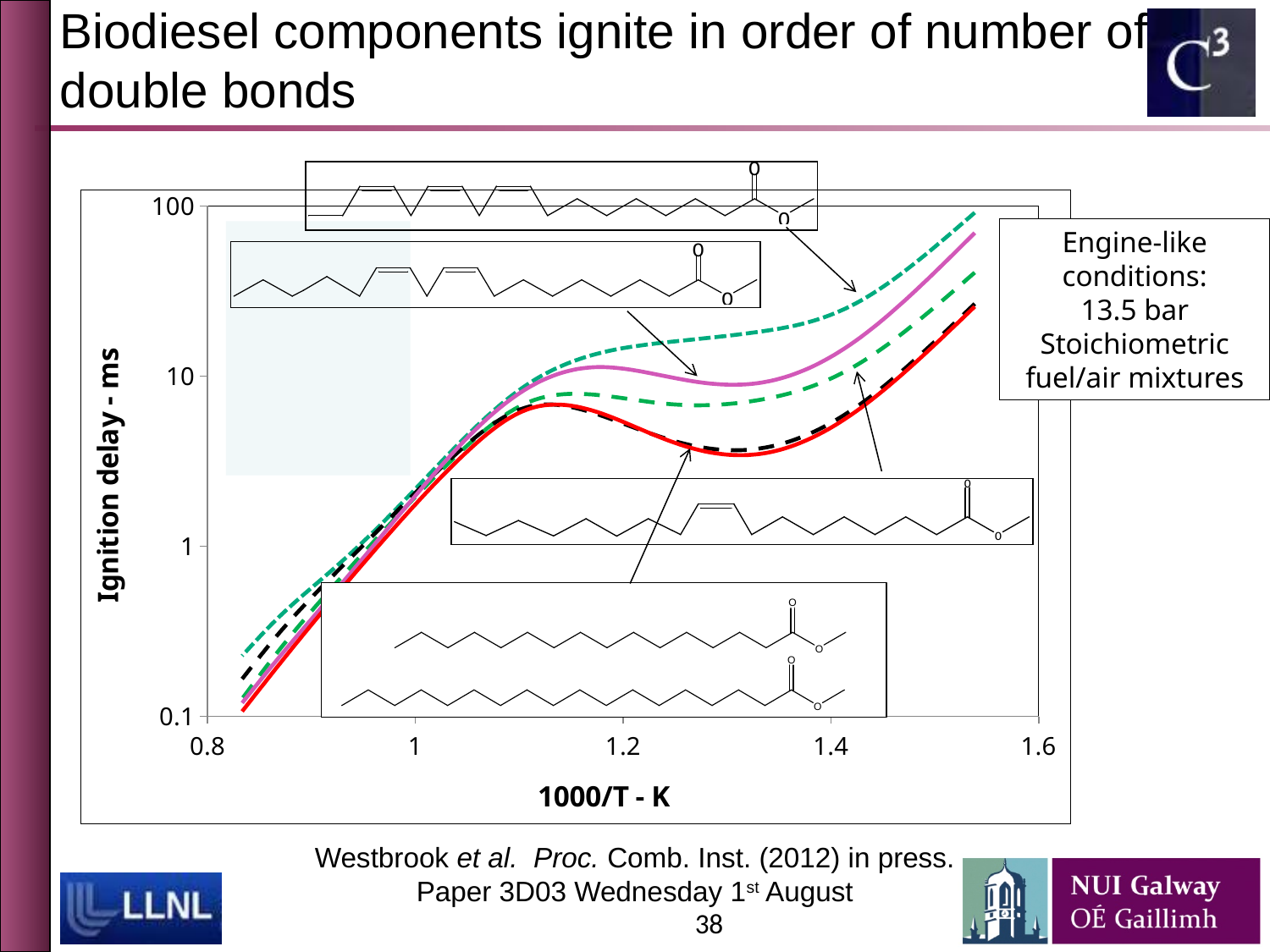
Overall, do the curves rise or fall as 1000/T increases from 0.8 to 1.6? rise At 1000/T = 1.0, is the value of the red solid curve greater or less than 1? greater At 1000/T = 1.2, is the value of the red solid curve greater or less than 10? less How many curves are plotted on the chart? 5 At 1000/T = 1.4, is the value of the top green dashed curve greater or less than 10? greater What is the title of the horizontal axis of the chart? 1000/T - K What is the title of the vertical axis of the chart? Ignition delay - ms At 1000/T = 1.4, is the pink solid curve higher or lower than the red solid curve? higher What is the lowest tick value shown on the vertical axis? 0.1 Which curve has the highest ignition delay at 1000/T = 1.4? the top green dashed curve What kind of chart is shown on the slide? line chart